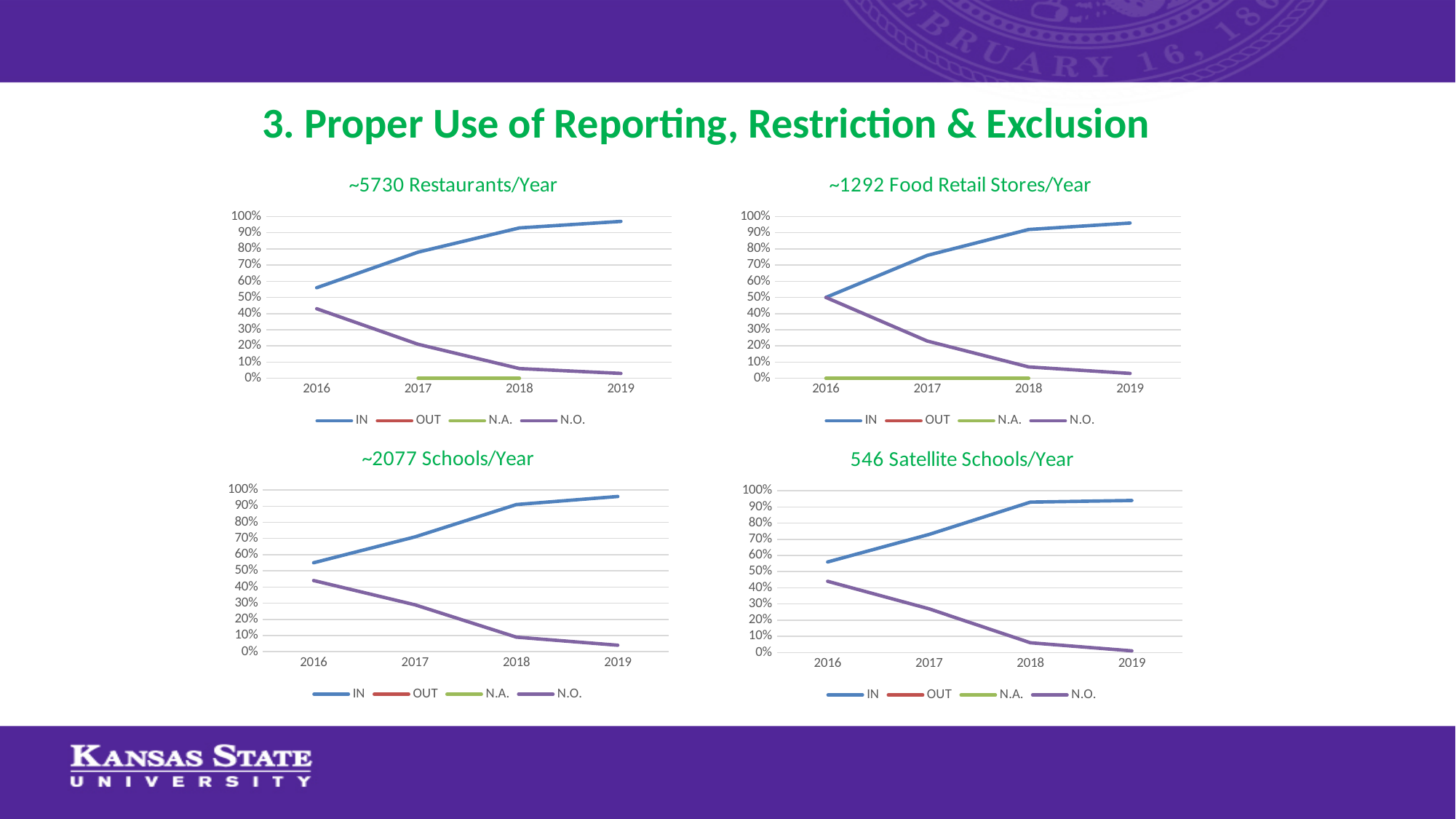
In the "546 Satellite Schools/Year" chart, is the N.O. value for 2019 greater or less than 10%? less How many series does the legend of the "~1292 Food Retail Stores/Year" chart list? 4 How many years are shown on the x axis of the "~2077 Schools/Year" chart? 4 In the "~5730 Restaurants/Year" chart, is the IN value for 2018 greater or less than 80%? greater What kind of chart is the "~5730 Restaurants/Year" chart? line chart In the "~2077 Schools/Year" chart, which series is higher in 2019, IN or N.O.? IN In the "~5730 Restaurants/Year" chart, in which year is the N.O. series highest? 2016 What is the title of the chart in the bottom right of the slide? 546 Satellite Schools/Year In the "~1292 Food Retail Stores/Year" chart, is the N.O. value for 2018 greater or less than 20%? less In the "546 Satellite Schools/Year" chart, does the N.O. series rise or fall from 2016 to 2019? fall In the "~5730 Restaurants/Year" chart, does the IN series rise or fall from 2016 to 2019? rise